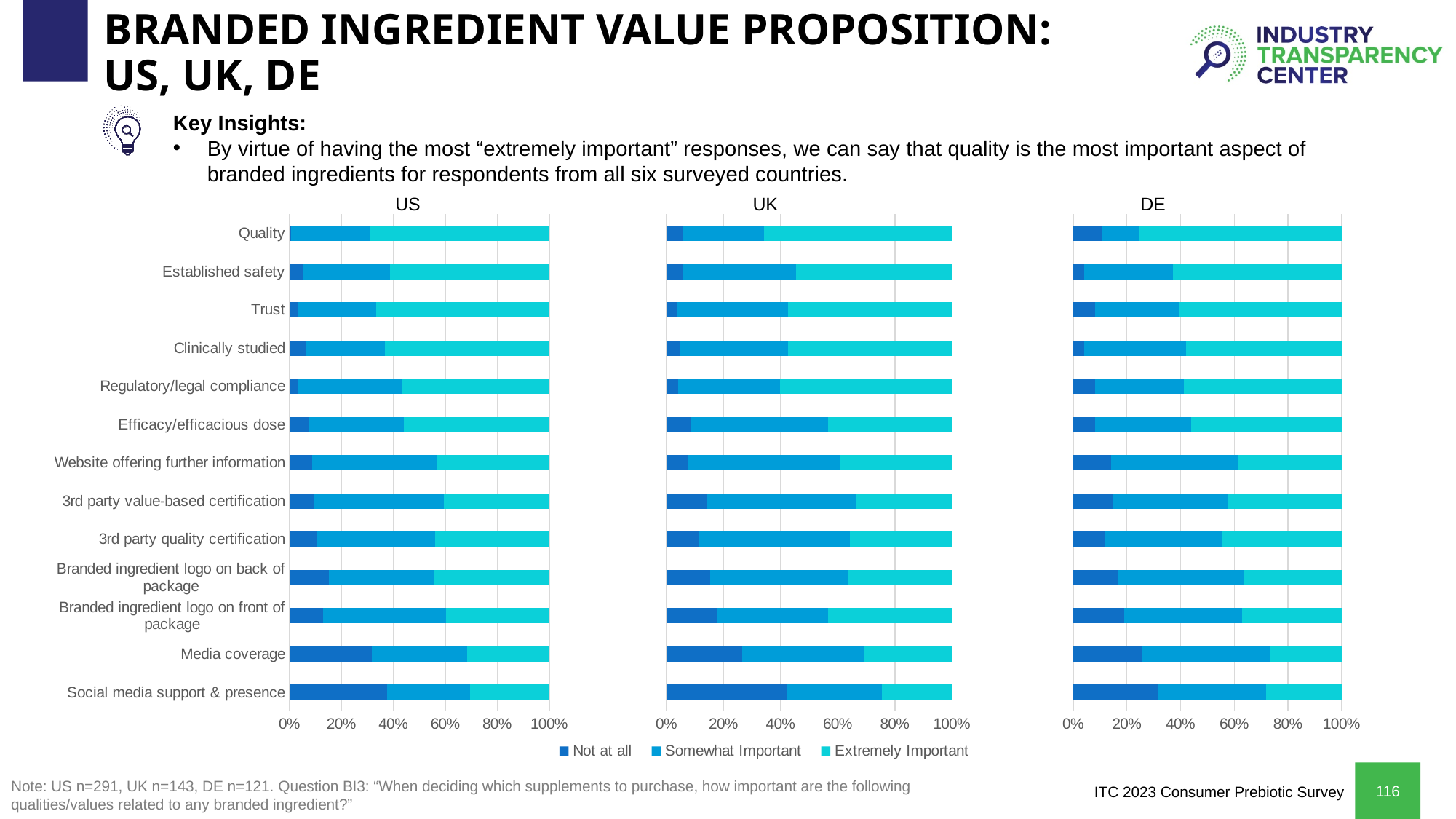
In the US chart, which category has the largest 'Not at all' share? Social media support & presence What kind of chart is used for the US, UK and DE panels on this slide? Stacked bar chart In the US chart, is the 'Not at all' share for Social media support & presence greater or less than 20%? greater How many series does the legend list for the charts? 3 In the DE chart, which has the larger 'Extremely Important' share: Quality or Media coverage? Quality How many categories are plotted in the US chart? 13 In the UK chart, which category has the largest 'Not at all' share? Social media support & presence In the UK chart, is the 'Extremely Important' share for Quality greater or less than 60%? greater In the DE chart, which category has the largest 'Extremely Important' share? Quality In the US chart, which category has the smallest 'Not at all' share? Quality What are the three series named in the legend? Not at all, Somewhat Important, Extremely Important What are the titles of the three charts on the slide? US, UK, DE